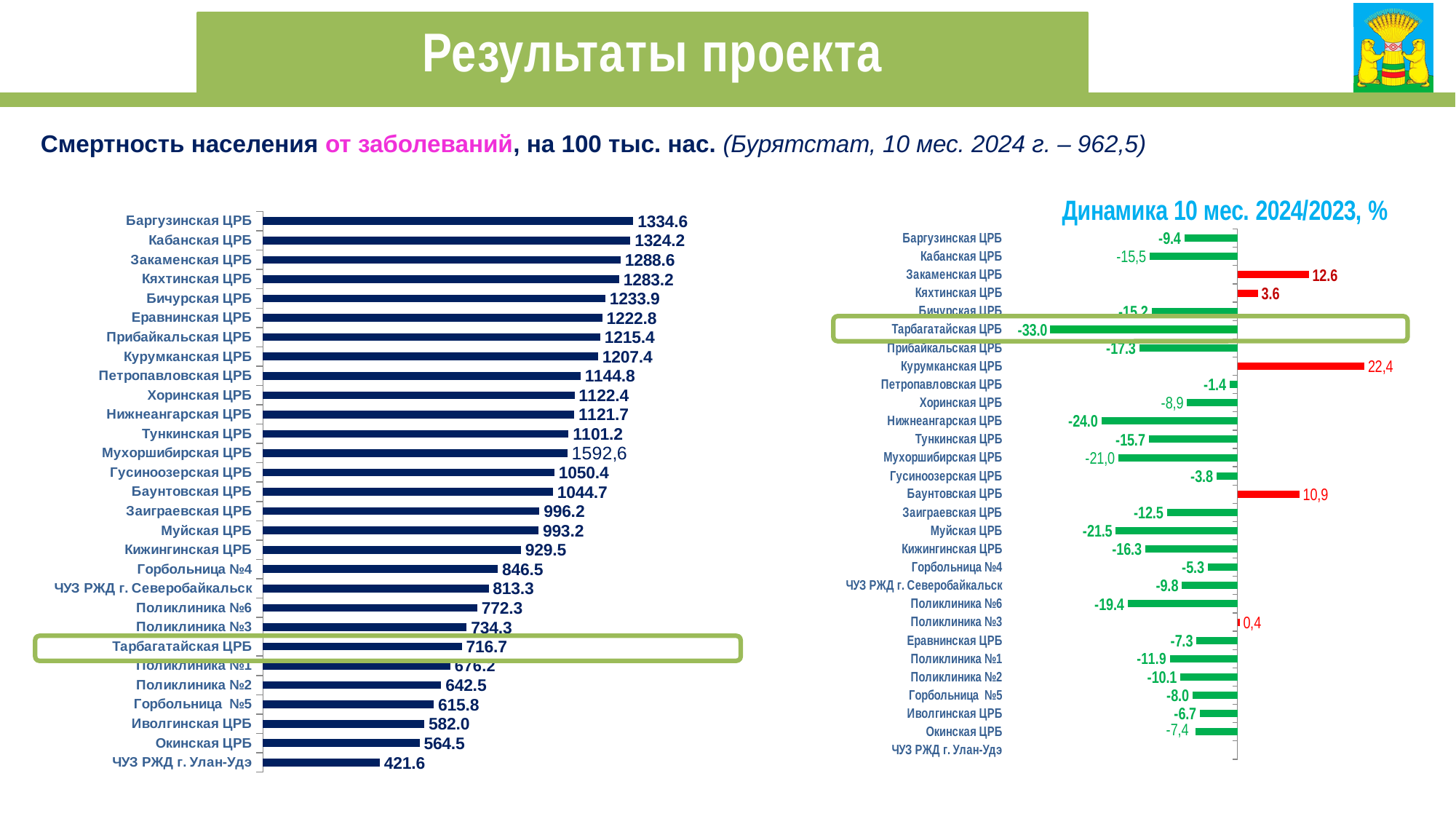
In the left chart (mortality per 100 thousand population), what is the value for Тарбагатайская ЦРБ? 716.7 In the left chart (mortality per 100 thousand population), what is the value for Баргузинская ЦРБ? 1334.6 In the left chart (mortality per 100 thousand population), which is larger: Поликлиника №6 or Поликлиника №3? Поликлиника №6 In the left chart (mortality per 100 thousand population), which category has the highest value? Баргузинская ЦРБ In the left chart (mortality per 100 thousand population), which category has the lowest value? ЧУЗ РЖД г. Улан-Удэ In the right chart 'Динамика 10 мес. 2024/2023, %', which category has the lowest value? Тарбагатайская ЦРБ In the left chart (mortality per 100 thousand population), what is the difference between Кабанская ЦРБ and Закаменская ЦРБ? 35.6 What kind of chart is the left chart (mortality per 100 thousand population)? bar chart In the right chart 'Динамика 10 мес. 2024/2023, %', what colour are the bars with positive values? red In the right chart 'Динамика 10 мес. 2024/2023, %', what is the value for Курумканская ЦРБ? 22,4 In the right chart 'Динамика 10 мес. 2024/2023, %', what is the value for Тарбагатайская ЦРБ? -33.0 In the right chart 'Динамика 10 мес. 2024/2023, %', which category has the highest value? Курумканская ЦРБ